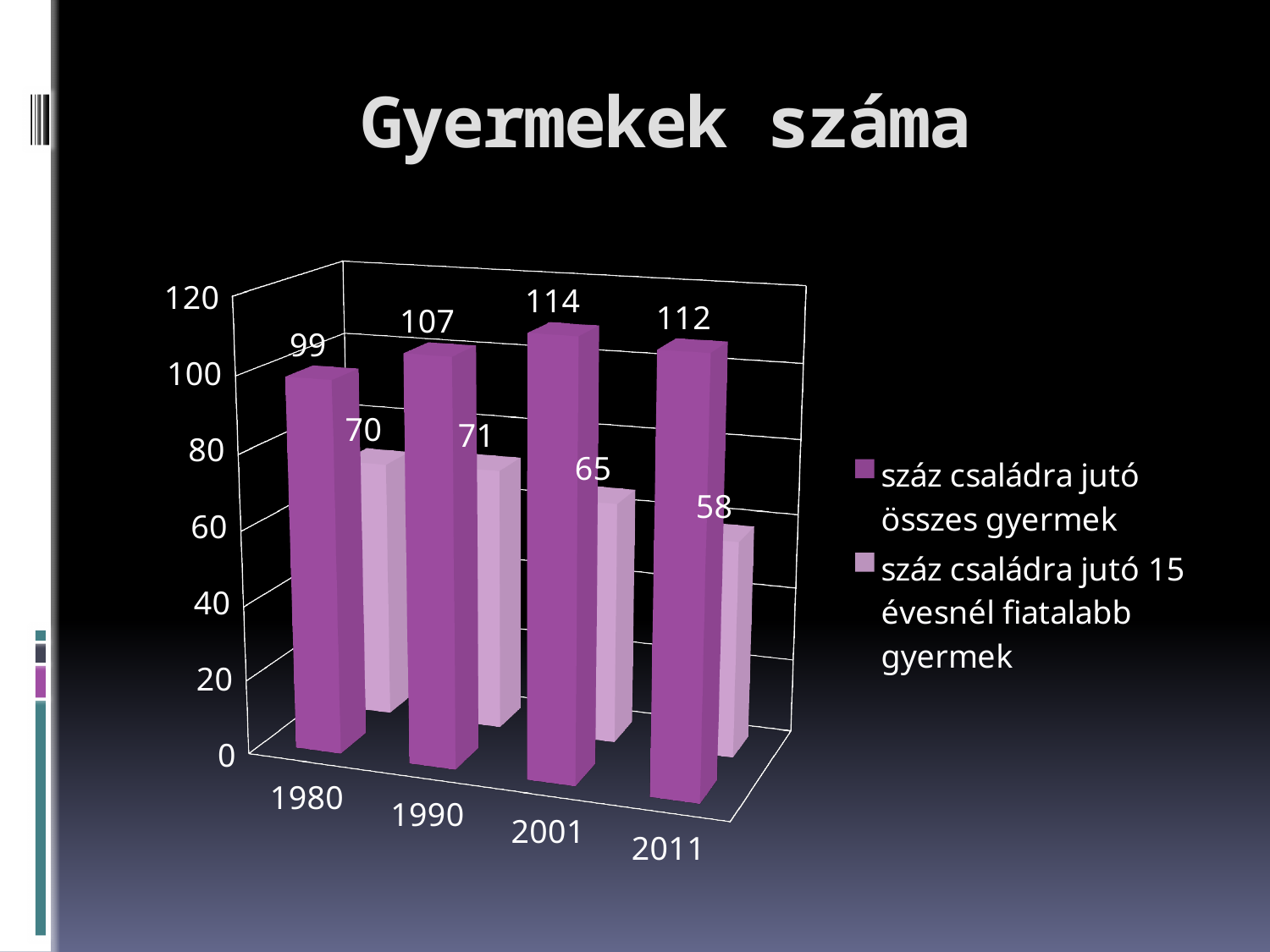
How many series does the legend list? 2 What is the value for 'száz családra jutó összes gyermek' in 1980? 99 Which is larger: 'száz családra jutó 15 évesnél fiatalabb gyermek' in 1990 or in 2001? 1990 How many years are shown on the x axis? 4 What is the title of the chart? Gyermekek száma In which year is 'száz családra jutó összes gyermek' highest? 2001 What is the value for 'száz családra jutó 15 évesnél fiatalabb gyermek' in 2011? 58 What is the value for 'száz családra jutó összes gyermek' in 2001? 114 What kind of chart is shown on the slide? bar chart Does 'száz családra jutó 15 évesnél fiatalabb gyermek' rise or fall from 1990 to 2011? fall In which year is 'száz családra jutó 15 évesnél fiatalabb gyermek' lowest? 2011 What is the difference between 'száz családra jutó összes gyermek' and 'száz családra jutó 15 évesnél fiatalabb gyermek' in 2011? 54